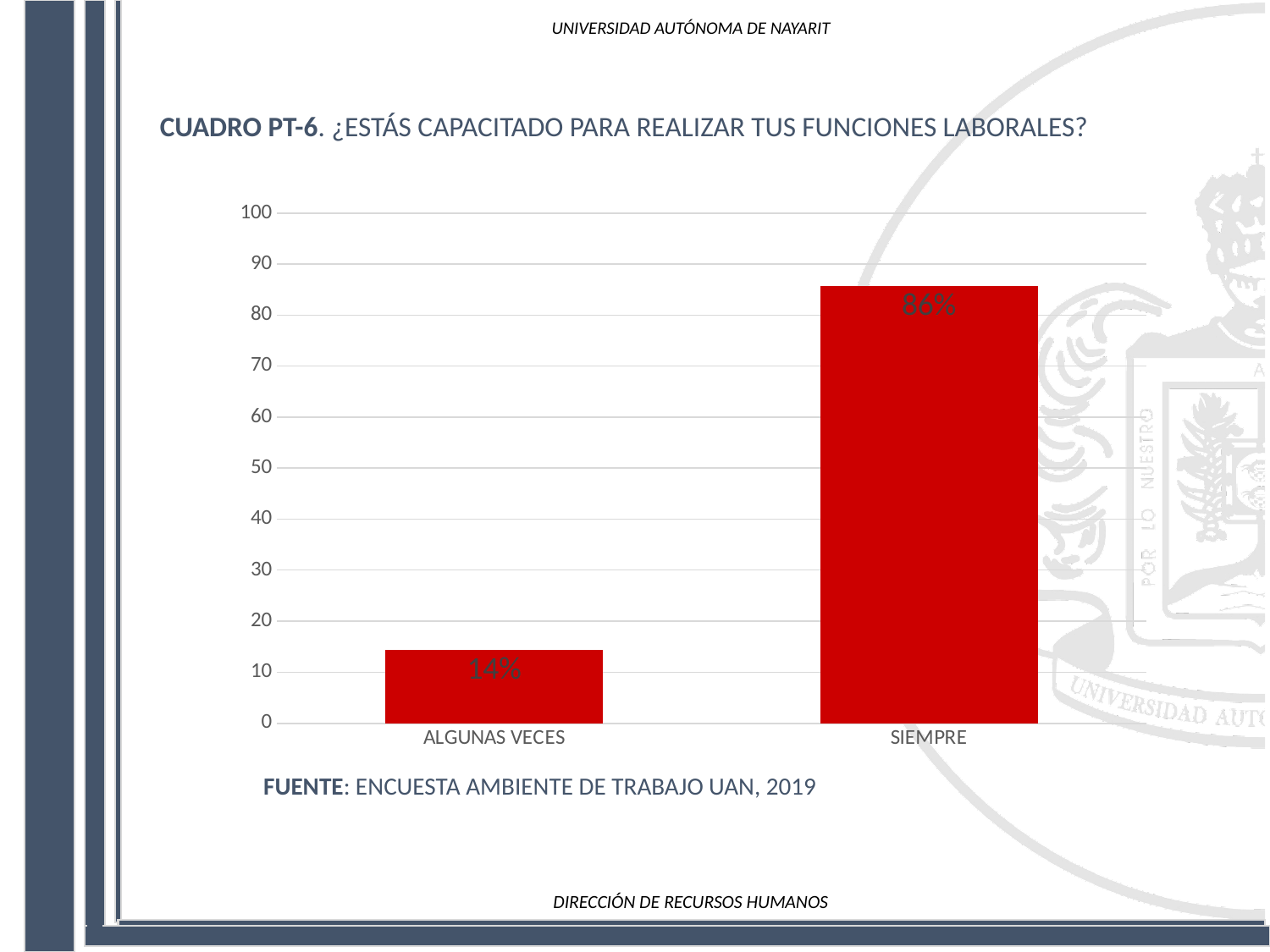
Which category has the lowest value? ALGUNAS VECES What is the value for SIEMPRE? 86% What is the title of the chart? CUADRO PT-6. ¿ESTÁS CAPACITADO PARA REALIZAR TUS FUNCIONES LABORALES? What is the value for ALGUNAS VECES? 14% What kind of chart is shown on the slide? Bar chart What is the source cited below the chart? ENCUESTA AMBIENTE DE TRABAJO UAN, 2019 How many categories are shown on the x axis? 2 Which is larger, the value for ALGUNAS VECES or the value for SIEMPRE? SIEMPRE Which category has the highest value? SIEMPRE Is the value for SIEMPRE greater or less than 80? greater Is the value for ALGUNAS VECES greater or less than 20? less What is the difference between the values for SIEMPRE and ALGUNAS VECES? 72%